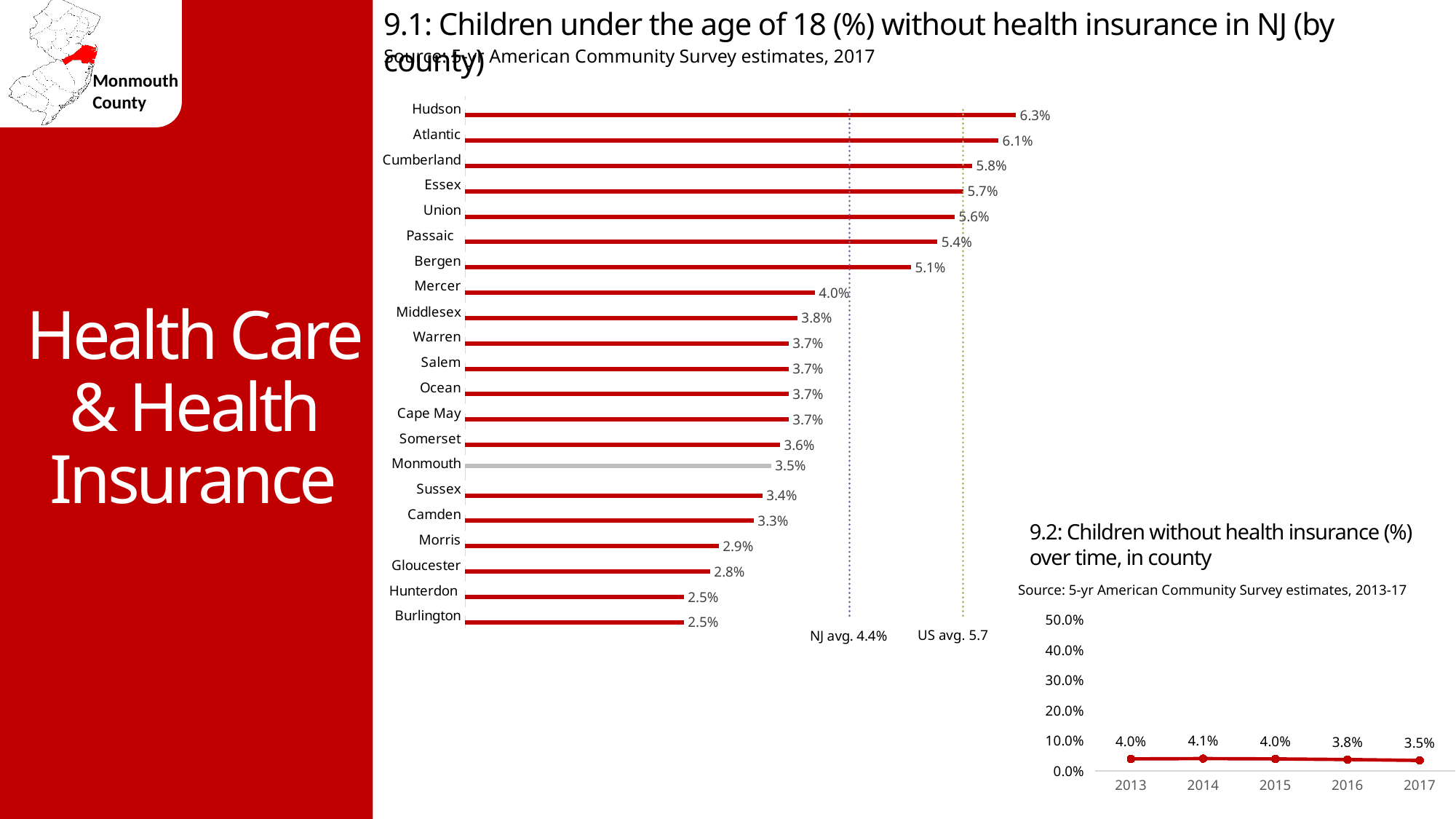
In chart 9.1, what NJ average is marked by the dotted line? 4.4% In chart 9.1, which county has the highest percentage of children without health insurance? Hudson In chart 9.1, how many counties are shown? 21 In chart 9.1, which is larger, the value for Passaic or the value for Mercer? Passaic In chart 9.2, what is the difference between the 2013 and 2017 values? 0.5% In chart 9.2, which year has the lowest value? 2017 In chart 9.1, what is the difference between Hudson and Monmouth? 2.8% In chart 9.2 (children without health insurance over time), what is the value for 2014? 4.1% In chart 9.1 (children under 18 without health insurance by county), what is the value for Monmouth? 3.5% In chart 9.1, what is the value for Bergen? 5.1% What kind of chart is chart 9.1? Bar chart What kind of chart is chart 9.2? Line chart